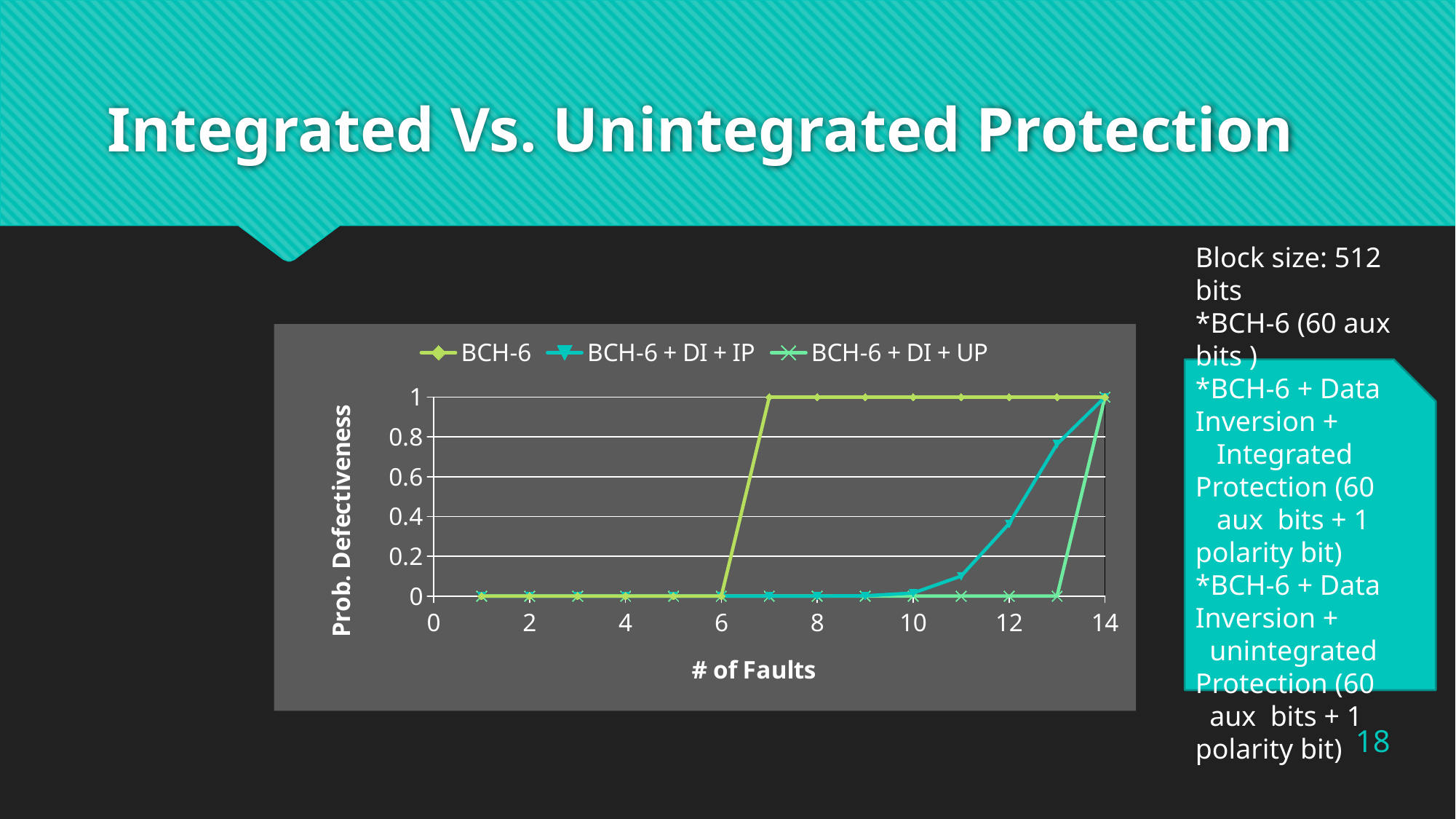
How many series does the legend list? 3 What is the Prob. Defectiveness for BCH-6 + DI + UP at 14 faults? 1 What is the label of the y axis? Prob. Defectiveness What is the label of the x axis? # of Faults At 12 faults, which series has the higher Prob. Defectiveness, BCH-6 or BCH-6 + DI + IP? BCH-6 What is the Prob. Defectiveness for BCH-6 + DI + UP at 13 faults? 0 Is the value for BCH-6 + DI + IP at 13 faults greater or less than 0.6? greater What kind of chart is shown on the slide? line chart What is the Prob. Defectiveness for BCH-6 at 7 faults? 1 Is the value for BCH-6 + DI + IP at 11 faults greater or less than 0.2? less Does the Prob. Defectiveness for BCH-6 + DI + IP rise or fall as the number of faults increases? rise What is the Prob. Defectiveness for BCH-6 at 6 faults? 0